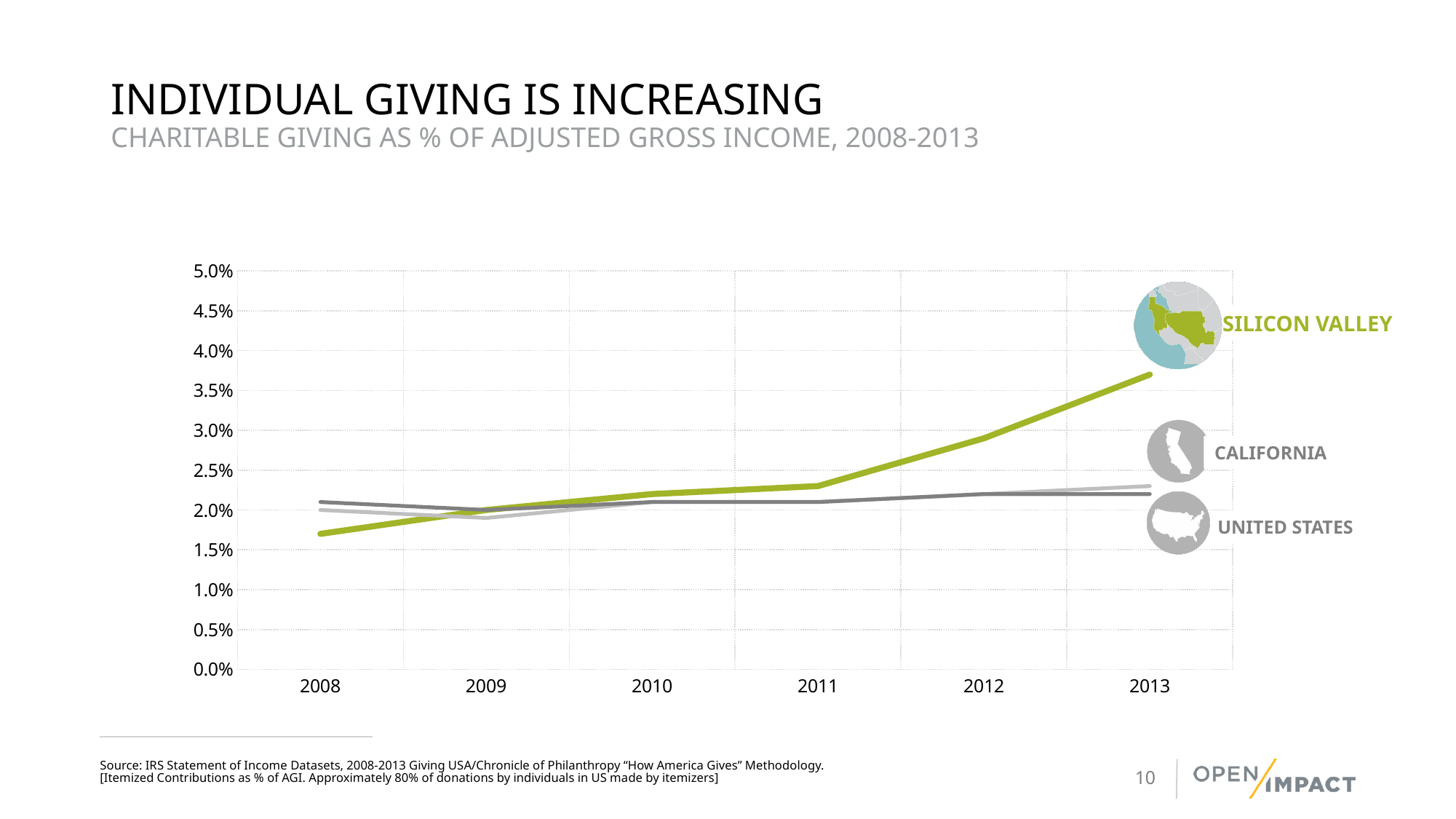
How many series does the chart's legend list? 3 What kind of chart is shown on the slide? line chart What is the subtitle describing the chart's measure? Charitable giving as % of adjusted gross income, 2008-2013 Is the value for Silicon Valley in 2008 greater or less than 2.0%? less Which series has the highest value in 2013? Silicon Valley Is the value for Silicon Valley in 2013 greater or less than 3.0%? greater How many years are plotted along the x axis? 6 Which series has the lowest value in 2008? Silicon Valley Which series is drawn in green? Silicon Valley In 2012, which is larger: the value for Silicon Valley or the value for United States? Silicon Valley Is the value for United States in 2013 greater or less than 2.5%? less Does the Silicon Valley line rise or fall from 2008 to 2013? rises